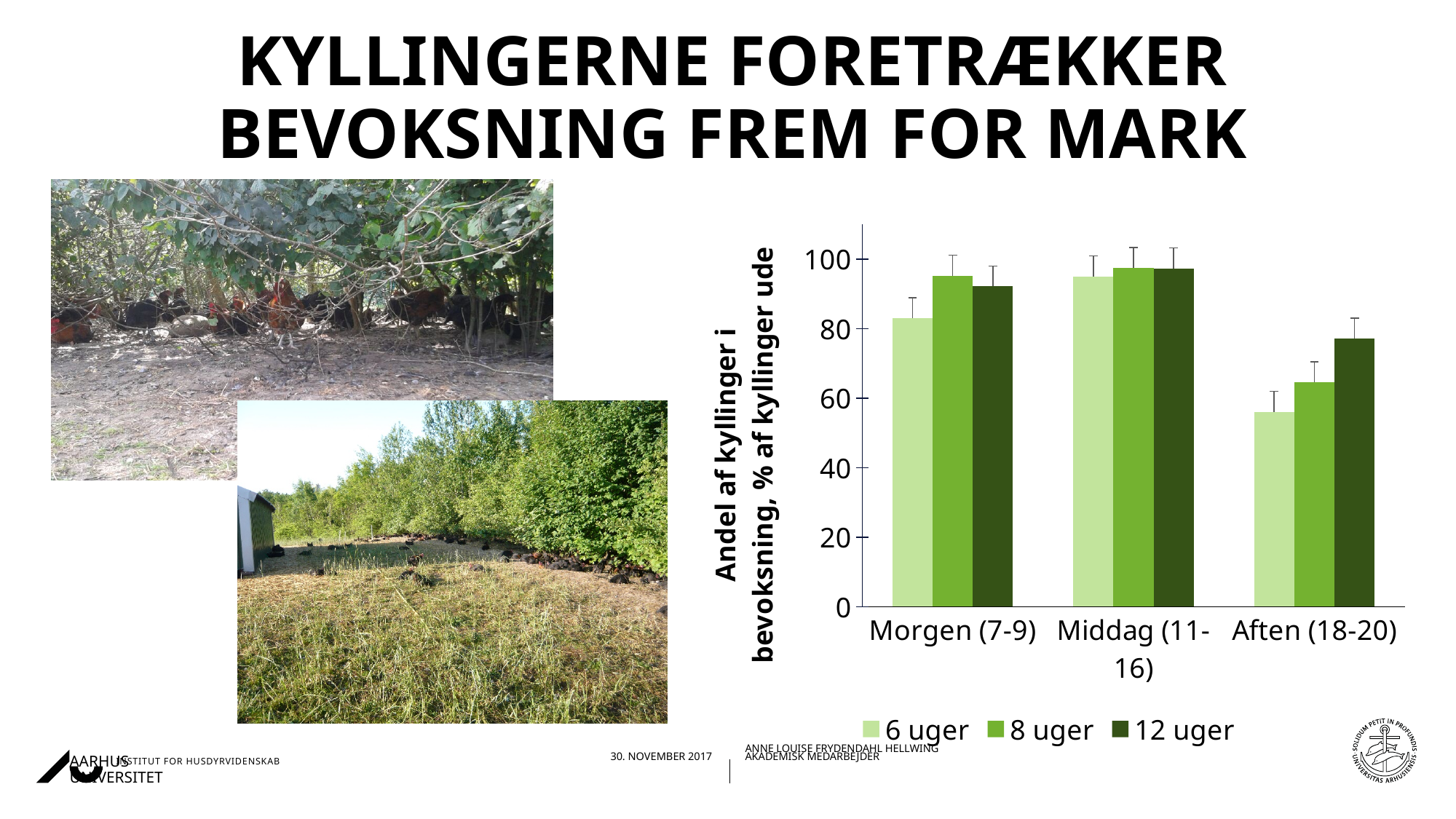
How many time-of-day categories are shown on the x axis of the chart? 3 How many series does the chart's legend list? 3 At Aften (18-20), which series has the lowest value? 6 uger Is the value for 6 uger at Aften (18-20) greater or less than 60? less Is the value for 6 uger at Middag (11-16) greater or less than 80? greater Within the Aften (18-20) category, do the values rise or fall going from 6 uger to 12 uger? rise What kind of chart is shown on the slide? bar chart At Aften (18-20), which series has the highest value? 12 uger What are the three series listed in the chart's legend? 6 uger, 8 uger, 12 uger Which is larger: the 6 uger value at Morgen (7-9) or the 6 uger value at Aften (18-20)? Morgen (7-9) For the 6 uger series, which time-of-day category has the lowest value? Aften (18-20) Is the value for 12 uger at Morgen (7-9) greater or less than 80? greater